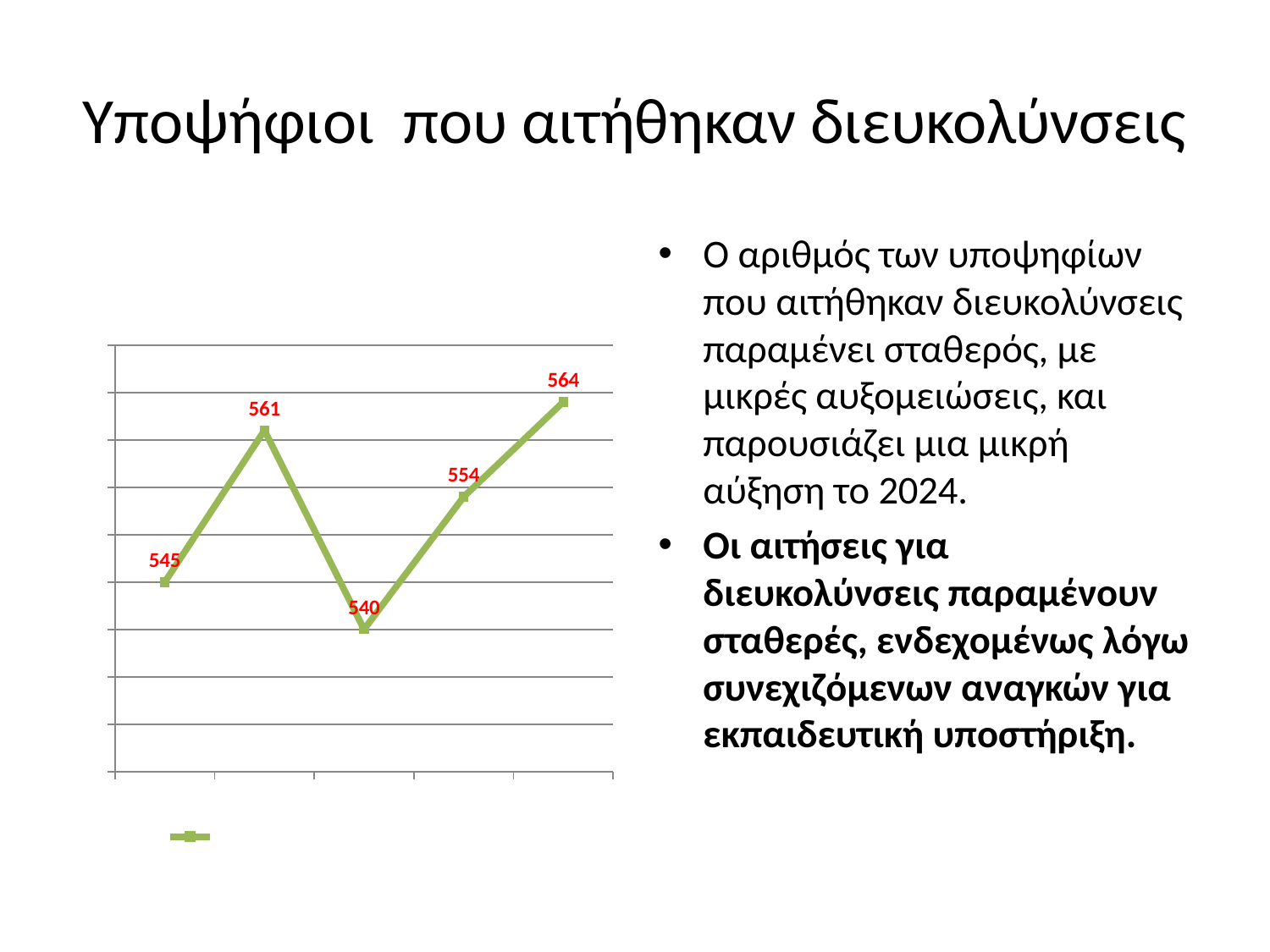
What kind of chart is shown on the slide? line chart What is the difference between the second data point (561) and the third data point (540)? 21 What is the difference between the highest and lowest values on the line chart? 24 What is the value of the last data point on the line chart? 564 What is the lowest value shown on the line chart? 540 What is the highest value shown on the line chart? 564 What is the value of the second data point on the line chart? 561 What is the value of the first data point on the line chart? 545 What is the value of the third data point on the line chart? 540 Does the line rise or fall between the third and the last data point? rise How many data points are plotted on the line chart? 5 Which is larger, the fourth data point or the second data point? the second data point (561)